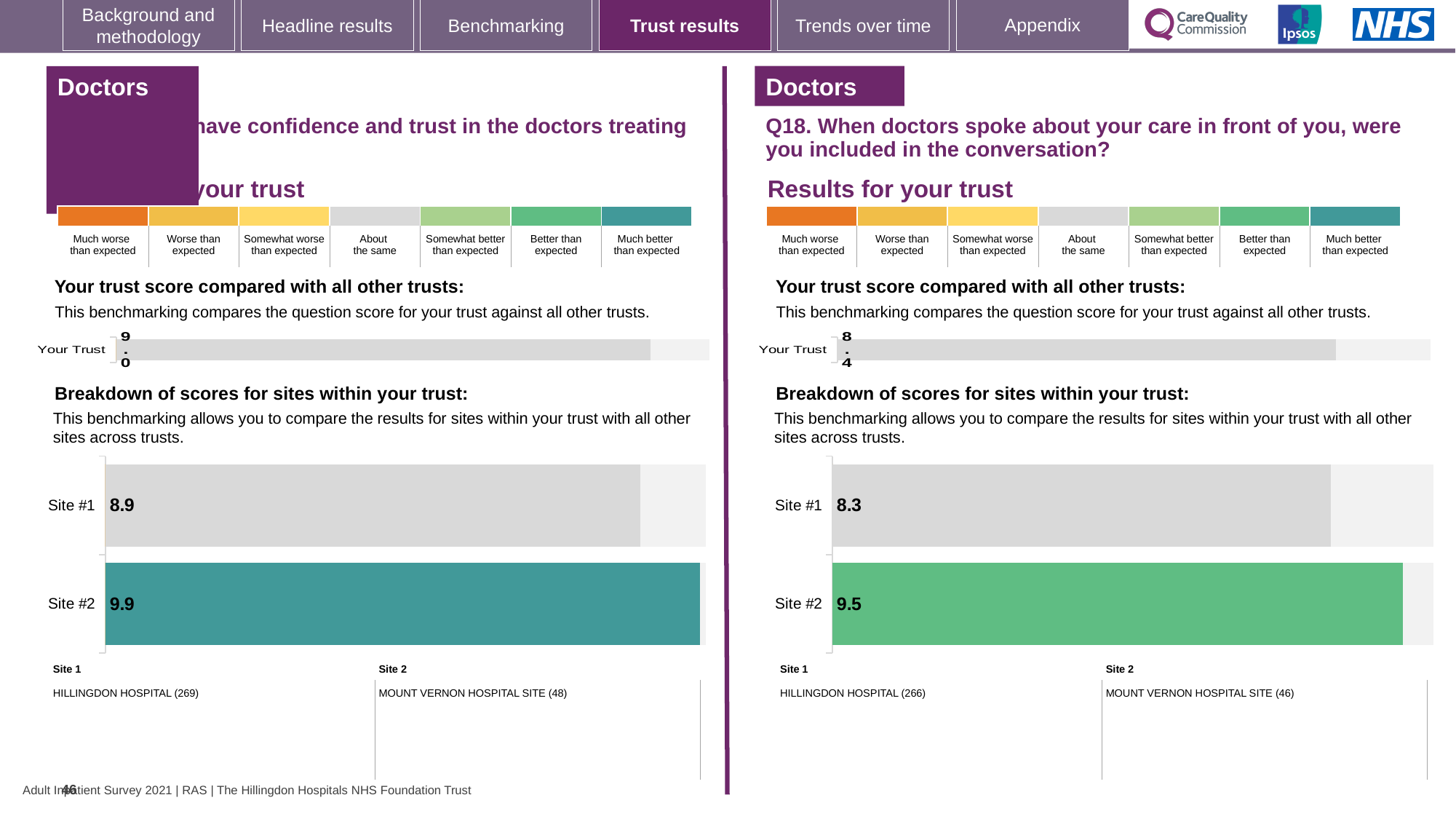
On the left-hand site breakdown chart, what is the score for Site #2? 9.9 On the left-hand site breakdown chart, which site has the lower score? Site #1 On the Q18 site breakdown chart on the right, what is the score for Site #2? 9.5 On the Q18 site breakdown chart on the right, what is the difference between the scores for Site #2 and Site #1? 1.2 What is the 'Your Trust' score shown on the Q18 chart on the right? 8.4 On the left-hand site breakdown chart, what is the score for Site #1? 8.9 How many sites are shown in the Q18 site breakdown chart on the right? 2 On the left-hand site breakdown chart, what is the difference between the scores for Site #2 and Site #1? 1.0 On the Q18 site breakdown chart on the right, what is the score for Site #1? 8.3 What kind of chart is used for the breakdown of scores for sites on the left-hand side? Bar chart On the Q18 site breakdown chart on the right, which site has the higher score? Site #2 What is the 'Your Trust' score shown on the left-hand chart? 9.0